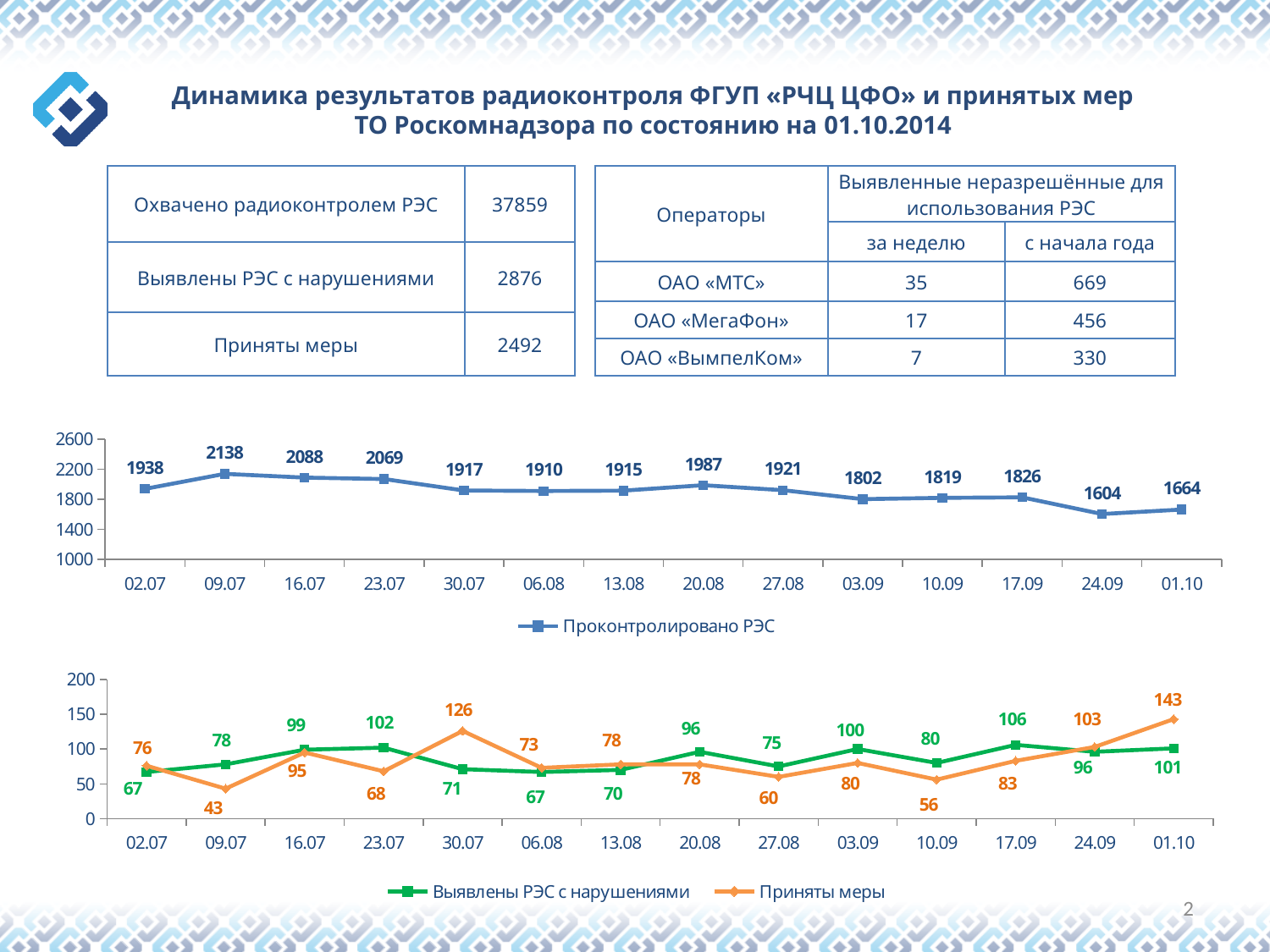
In the top chart (Проконтролировано РЭС), what is the difference between the values for 09.07 and 24.09? 534 In the bottom chart, what is the value of Приняты меры for 30.07? 126 In the bottom chart, which is larger on 27.08: Выявлены РЭС с нарушениями or Приняты меры? Выявлены РЭС с нарушениями In the bottom chart, on which date is Приняты меры lowest? 09.07 In the top chart (Проконтролировано РЭС), which date has the lowest value? 24.09 In the top chart (Проконтролировано РЭС), what is the value for 09.07? 2138 In the bottom chart, what is the difference between Приняты меры and Выявлены РЭС с нарушениями on 01.10? 42 In the bottom chart, what is the value of Выявлены РЭС с нарушениями for 17.09? 106 In the top chart (Проконтролировано РЭС), which date has the highest value? 09.07 In the bottom chart, on which date does Приняты меры reach its highest value? 01.10 In the top chart (Проконтролировано РЭС), how many data points are plotted? 14 How many series does the legend of the bottom chart list? 2